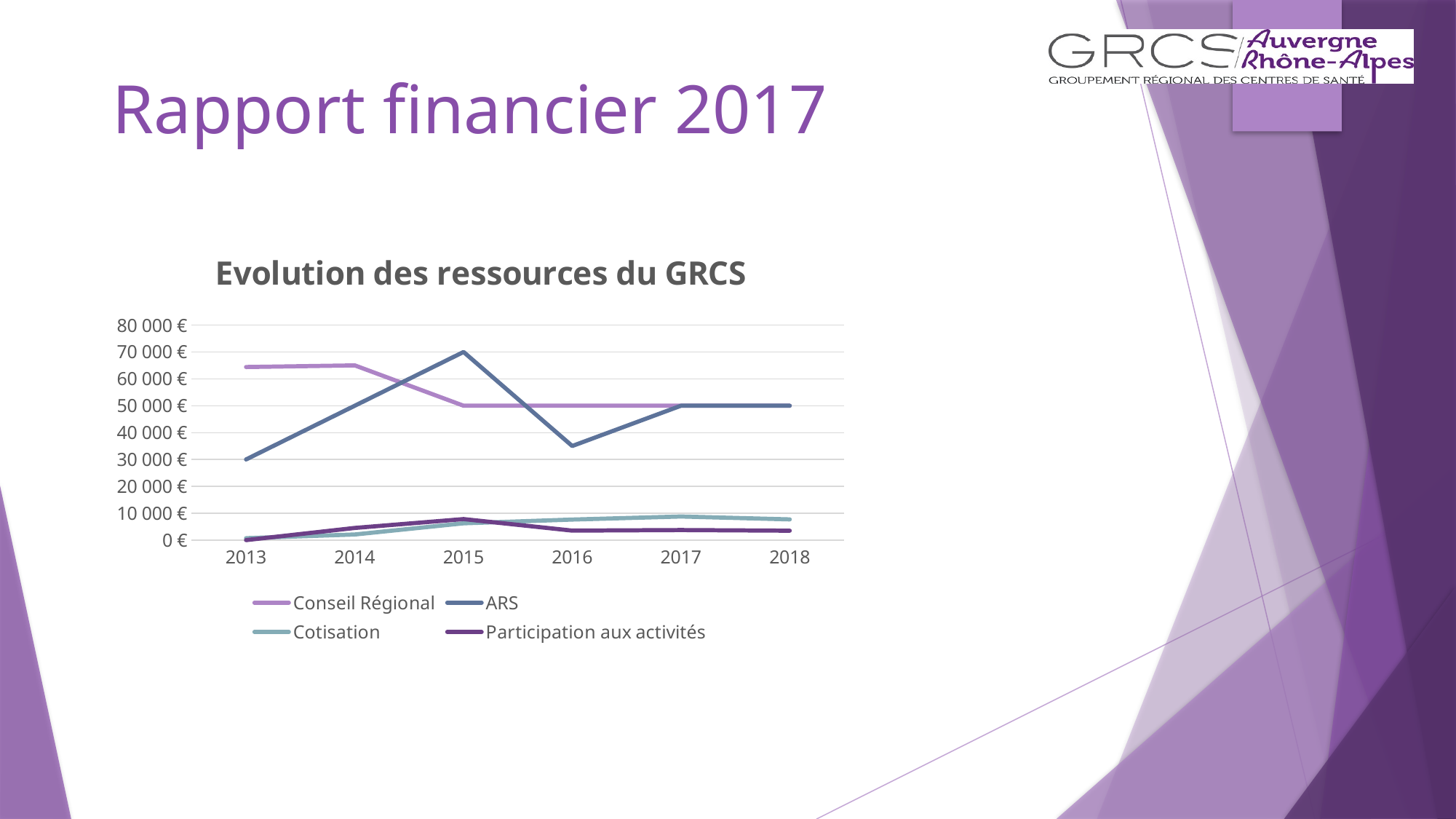
Is the value for Conseil Régional in 2013 greater or less than 60 000 €? greater How many series does the legend list? 4 What is the value for Conseil Régional in 2016? 50 000 € Is the value for ARS in 2016 greater or less than 40 000 €? less What is the title of the chart? Evolution des ressources du GRCS What kind of chart is shown on the slide? Line chart How many years are shown on the x axis? 6 Does the ARS value rise or fall from 2013 to 2015? Rise What is the value for ARS in 2015? 70 000 € In 2013, which is larger: Conseil Régional or ARS? Conseil Régional In which year is the ARS value highest? 2015 What is the value for ARS in 2013? 30 000 €